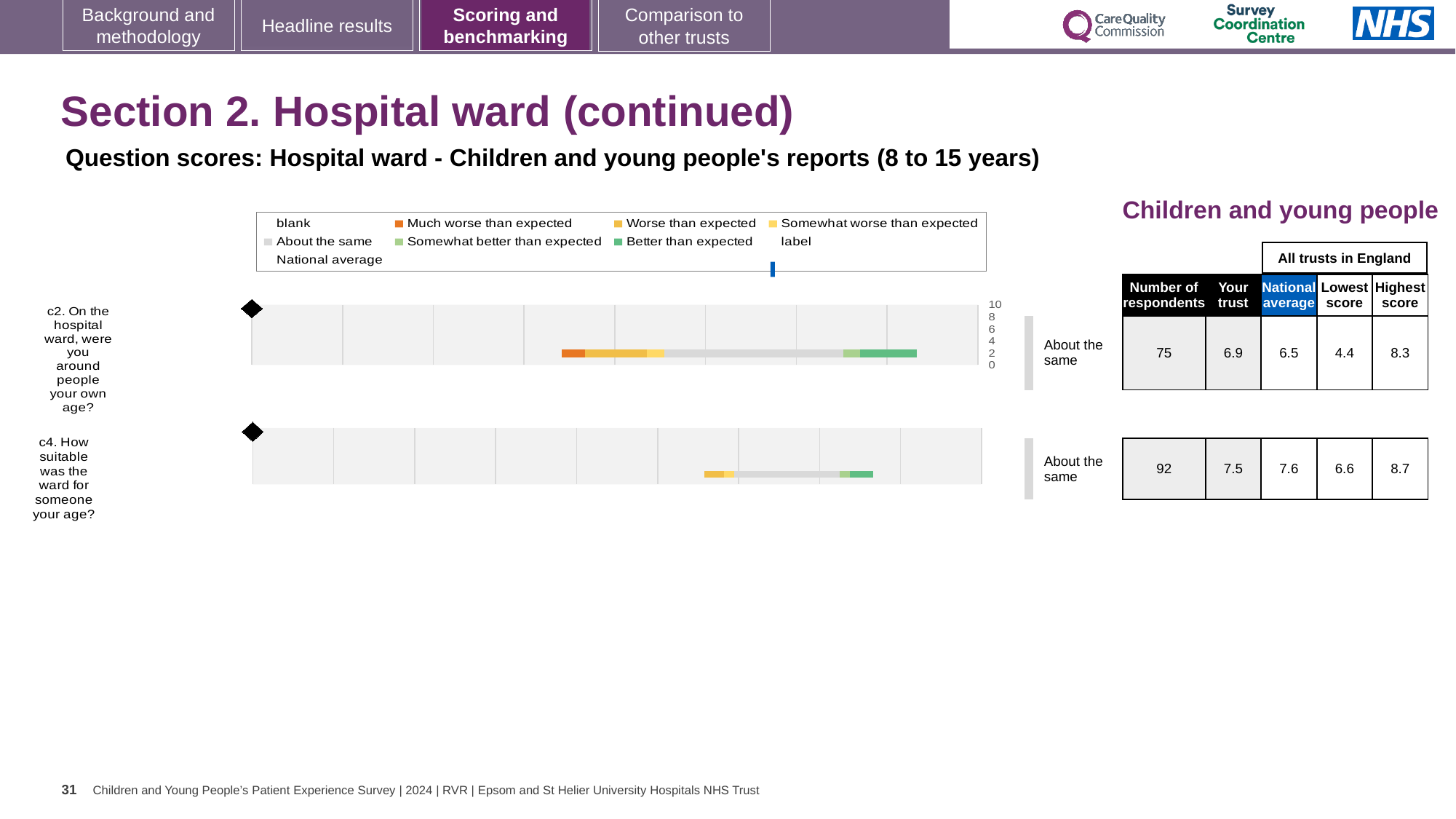
How many questions are plotted in the chart? 2 What is the subtitle describing the question scores shown on this slide? Question scores: Hospital ward - Children and young people's reports (8 to 15 years) For question c2, which is larger: the 'Your trust' score or the national average? Your trust What is the difference between the highest score and the lowest score for question c4? 2.1 What is the 'Your trust' score for question c2 (On the hospital ward, were you around people your own age?)? 6.9 Which question has the higher 'Your trust' score, c2 or c4? c4 What benchmark category is shown for question c2? About the same How many respondents answered question c4? 92 What is the national average score for question c4 (How suitable was the ward for someone your age?)? 7.6 What is the lowest score across all trusts in England for question c2? 4.4 What kind of chart is used to show the question scores on this slide? bar chart What is the difference between the highest score and the 'Your trust' score for question c2? 1.4